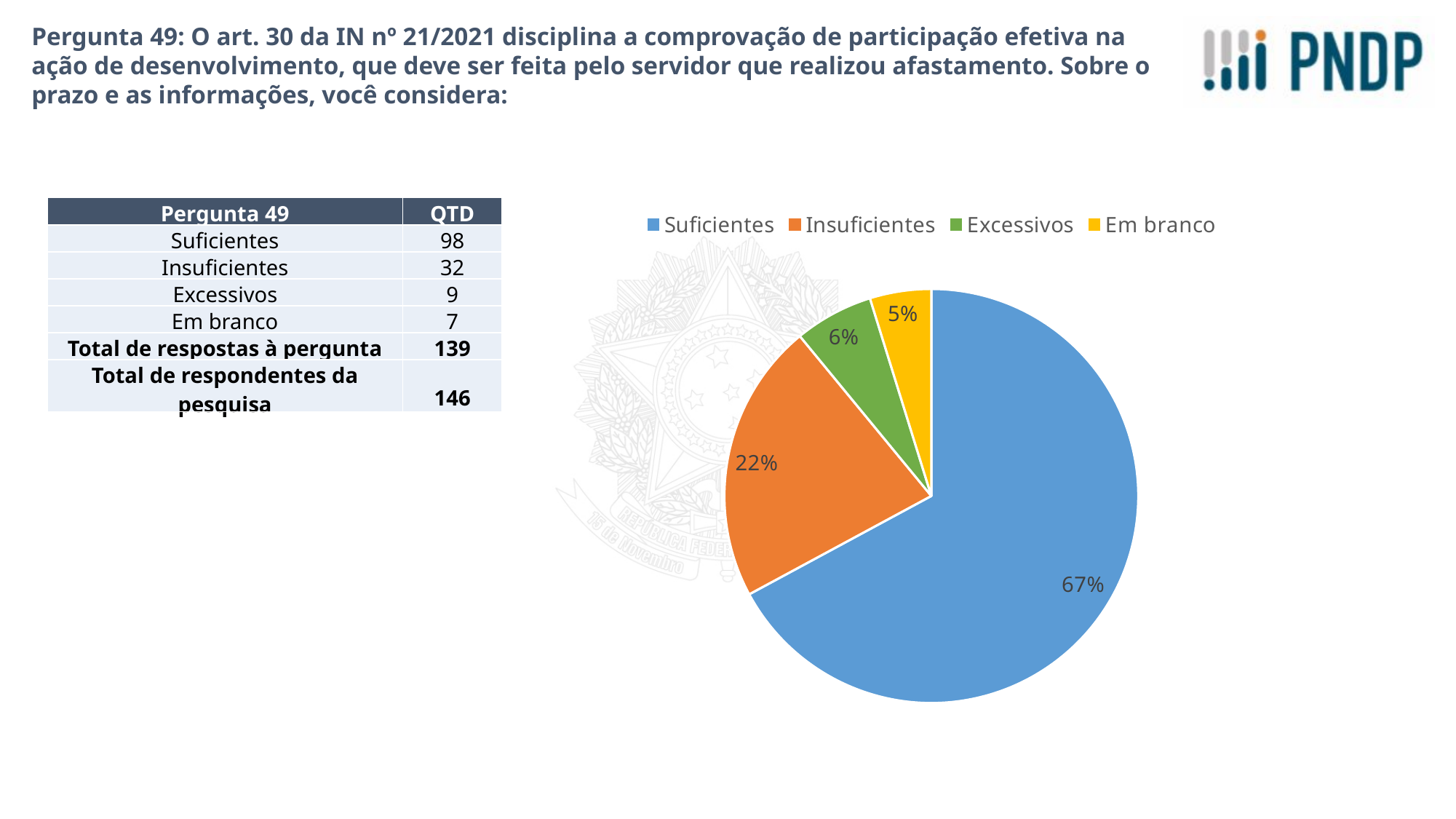
What share of the pie does the Suficientes slice represent? 67% Which category has the largest slice of the pie? Suficientes What share of the pie does the Excessivos slice represent? 6% How many slices does the pie chart have? 4 What is the difference in percentage points between the Suficientes and Insuficientes slices? 45 How many entries does the legend list? 4 Which category has the smallest slice of the pie? Em branco What kind of chart is shown on the slide? pie chart What share of the pie does the Insuficientes slice represent? 22% Which slice is larger, Insuficientes or Excessivos? Insuficientes What colour is the Em branco slice in the pie chart? yellow